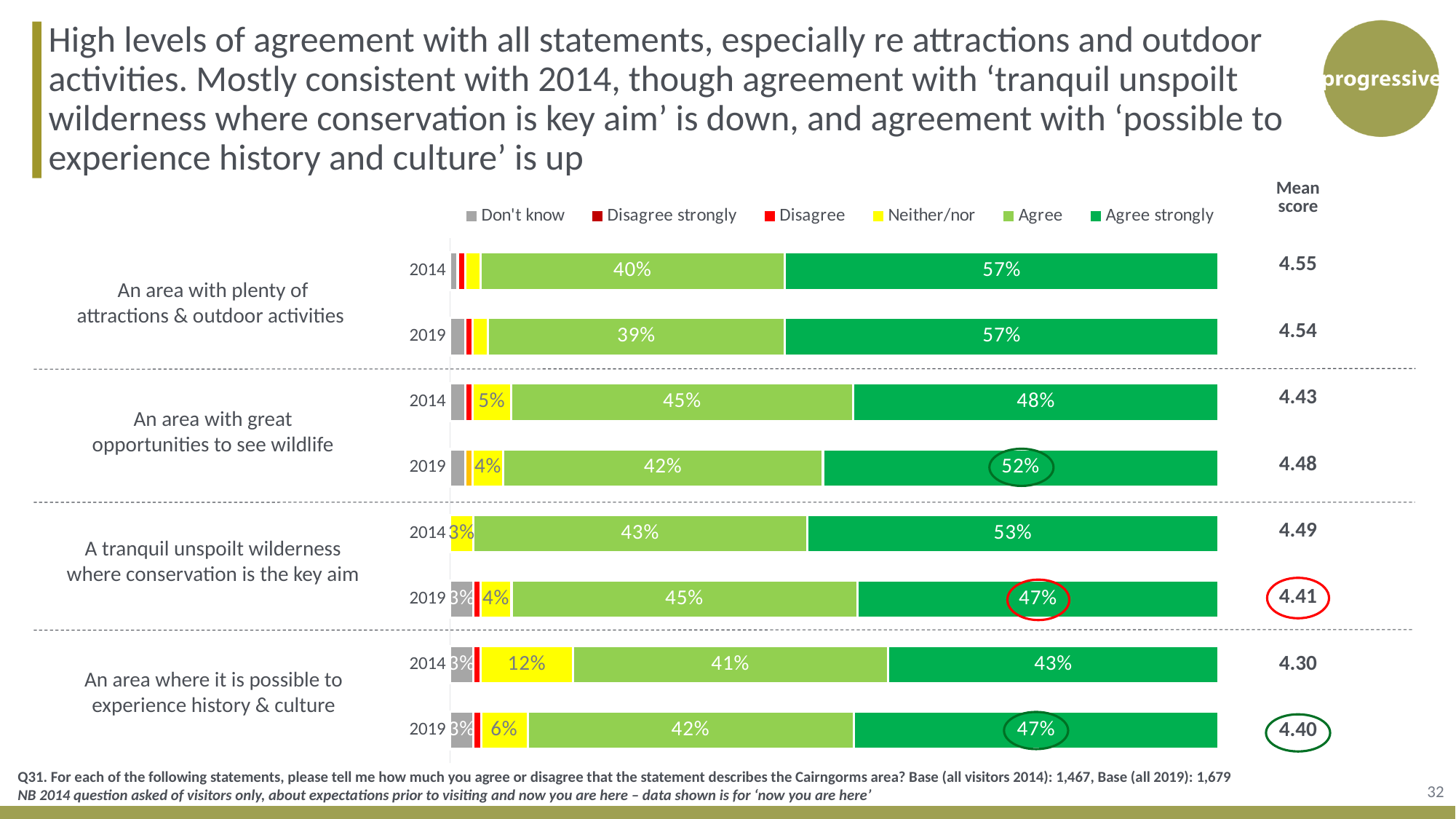
How many bars are plotted in the chart? 8 What is the 'Agree' percentage for 'An area with great opportunities to see wildlife' in 2019? 42% What is the 'Neither/nor' percentage for 'An area where it is possible to experience history & culture' in 2014? 12% What kind of chart is shown on the slide? Stacked bar chart Which year had the larger 'Agree strongly' share for 'A tranquil unspoilt wilderness where conservation is the key aim', 2014 or 2019? 2014 By how many percentage points did 'Agree strongly' for 'An area with great opportunities to see wildlife' change from 2014 to 2019? 4 percentage points (48% to 52%) What percentage of 2014 visitors agreed strongly that the Cairngorms is 'An area with plenty of attractions & outdoor activities'? 57% How many response categories does the legend list? 6 Which bar has the lowest mean score shown on the slide? An area where it is possible to experience history & culture, 2014 (4.30) Did the mean score for 'An area where it is possible to experience history & culture' rise or fall between 2014 and 2019? Rise (4.30 to 4.40) What is the mean score for 'A tranquil unspoilt wilderness where conservation is the key aim' in 2019? 4.41 Which statement has the highest mean score in 2019? An area with plenty of attractions & outdoor activities